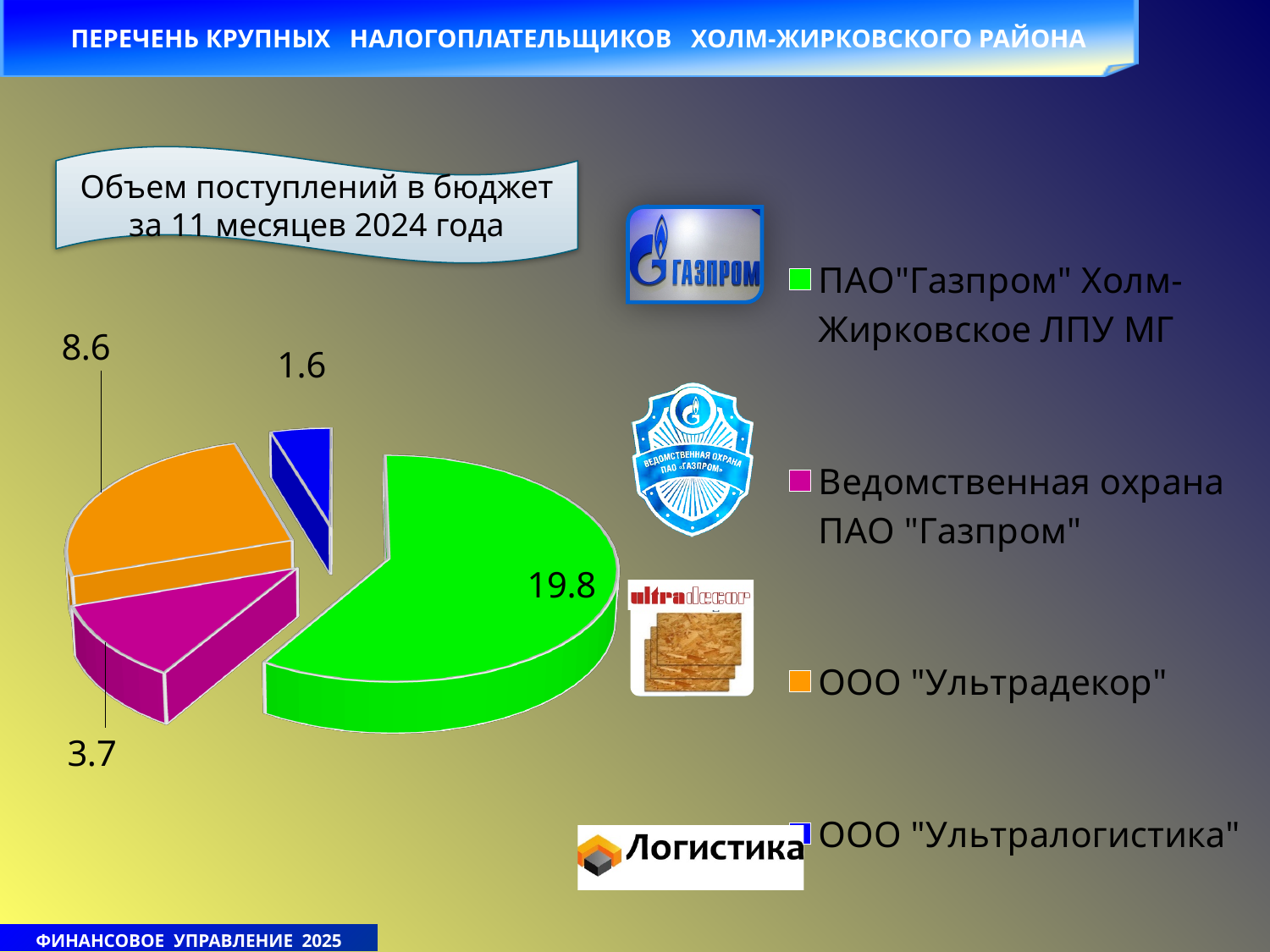
How many entries does the legend list? 4 What is the value for ПАО "Газпром" Холм-Жирковское ЛПУ МГ? 19.8 How many slices does the pie chart have? 4 Which taxpayer has the smallest slice of the pie? ООО "Ультралогистика" What type of chart is shown on the slide? Pie chart What is the value for ООО "Ультралогистика"? 1.6 What is the value for ООО "Ультрадекор"? 8.6 What is the value for Ведомственная охрана ПАО "Газпром"? 3.7 Which is larger: the value for ООО "Ультрадекор" or the value for Ведомственная охрана ПАО "Газпром"? ООО "Ультрадекор" Which taxpayer has the largest slice of the pie? ПАО "Газпром" Холм-Жирковское ЛПУ МГ What is the difference between the values for ПАО "Газпром" Холм-Жирковское ЛПУ МГ and ООО "Ультрадекор"? 11.2 What colour is the slice for ООО "Ультрадекор"? Orange